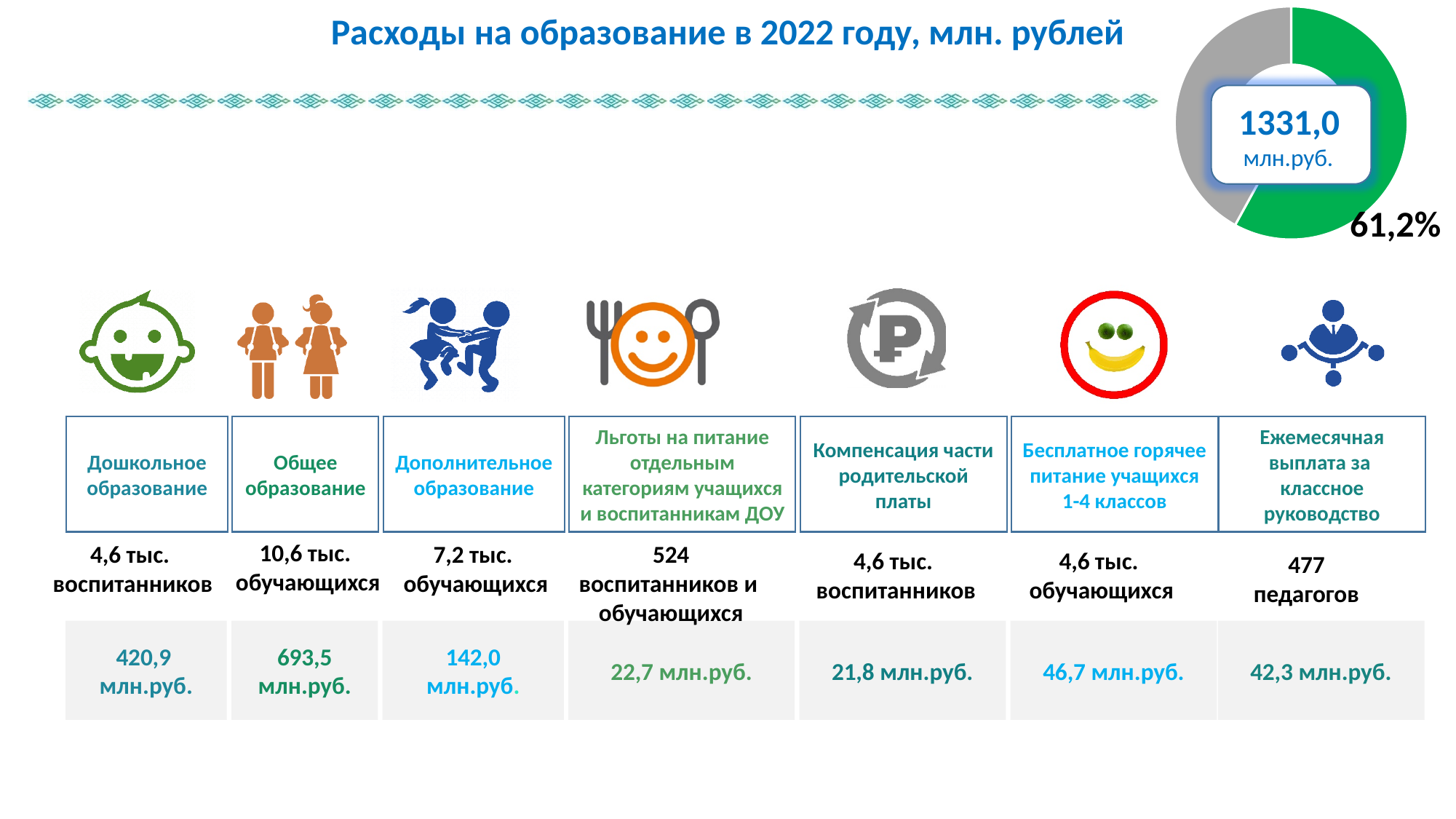
What is the title of the slide containing the donut chart? Расходы на образование в 2022 году, млн. рублей What kind of chart is shown in the top right corner of the slide? pie chart (donut) Which slice of the donut chart is larger, the green one or the grey one? green Is the green slice of the donut chart greater or less than 50% of the whole? greater In the infographic below the donut chart, which category has the highest spending? Общее образование How many slices does the donut chart have? 2 What colour is the larger slice of the donut chart? green In the infographic below the donut chart, what is the spending on Общее образование? 693,5 млн.руб. What percentage is labelled on the green slice of the donut chart? 61,2% In the infographic below the donut chart, which category has the lowest spending? Компенсация части родительской платы What value is printed in the centre of the donut chart? 1331,0 млн.руб. In the infographic below the donut chart, what is the difference between spending on Общее образование and Дошкольное образование? 272,6 млн.руб.